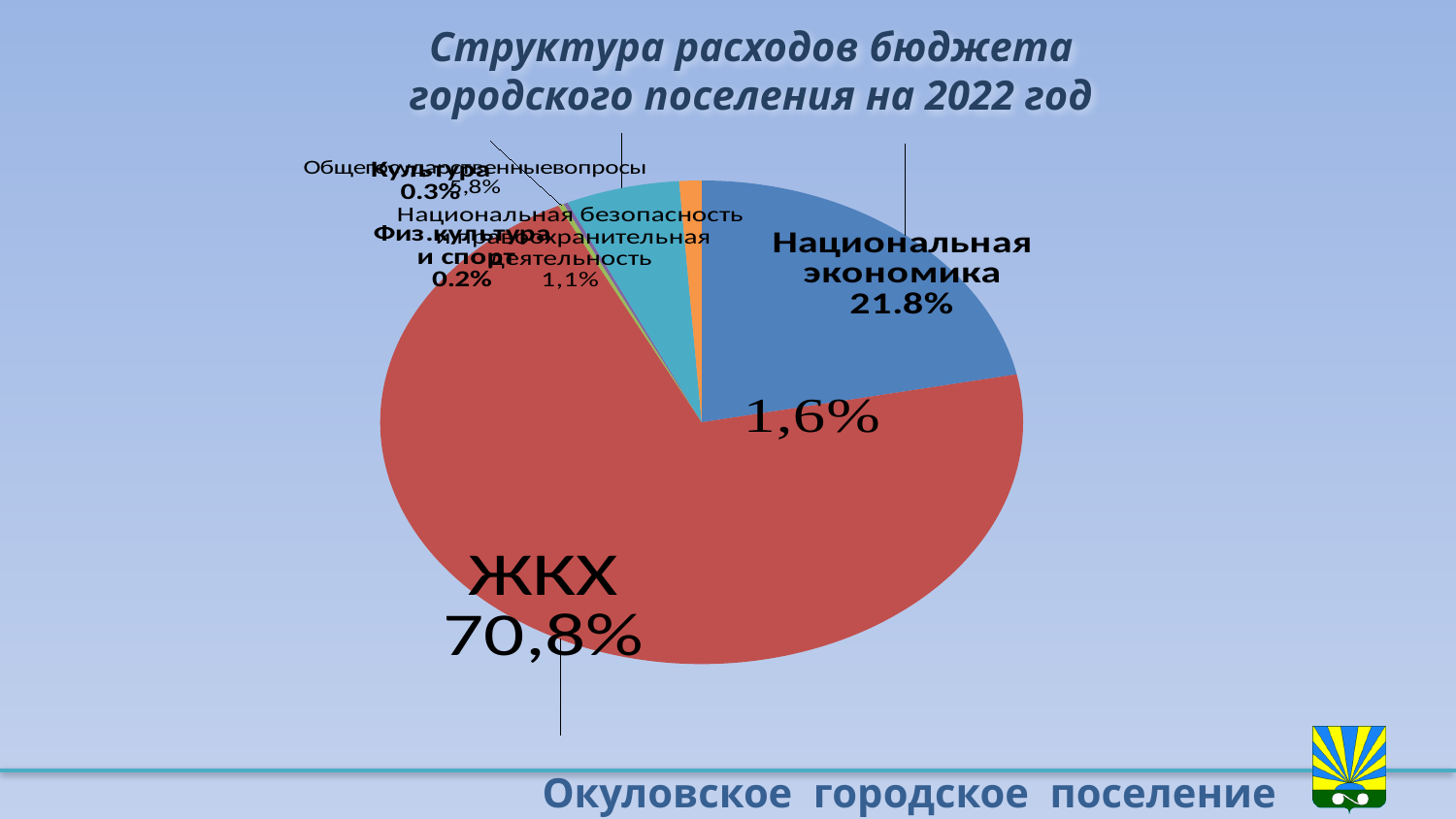
What share of the budget expenditure is ЖКХ? 70,8% What is the title of the chart? Структура расходов бюджета городского поселения на 2022 год Which is larger: the share for ЖКХ or the share for Национальная экономика? ЖКХ Which category has the largest share of the budget expenditure? ЖКХ What share of the budget expenditure is Физ.культура и спорт? 0.2% By how many percentage points does the share for ЖКХ exceed the share for Национальная экономика? 49% What share of the budget expenditure is Национальная безопасность и правоохранительная деятельность? 1,1% What kind of chart is shown on the slide? pie chart What colour is the ЖКХ slice of the pie? red What share of the budget expenditure is Культура? 0.3% What share of the budget expenditure is Национальная экономика? 21.8%